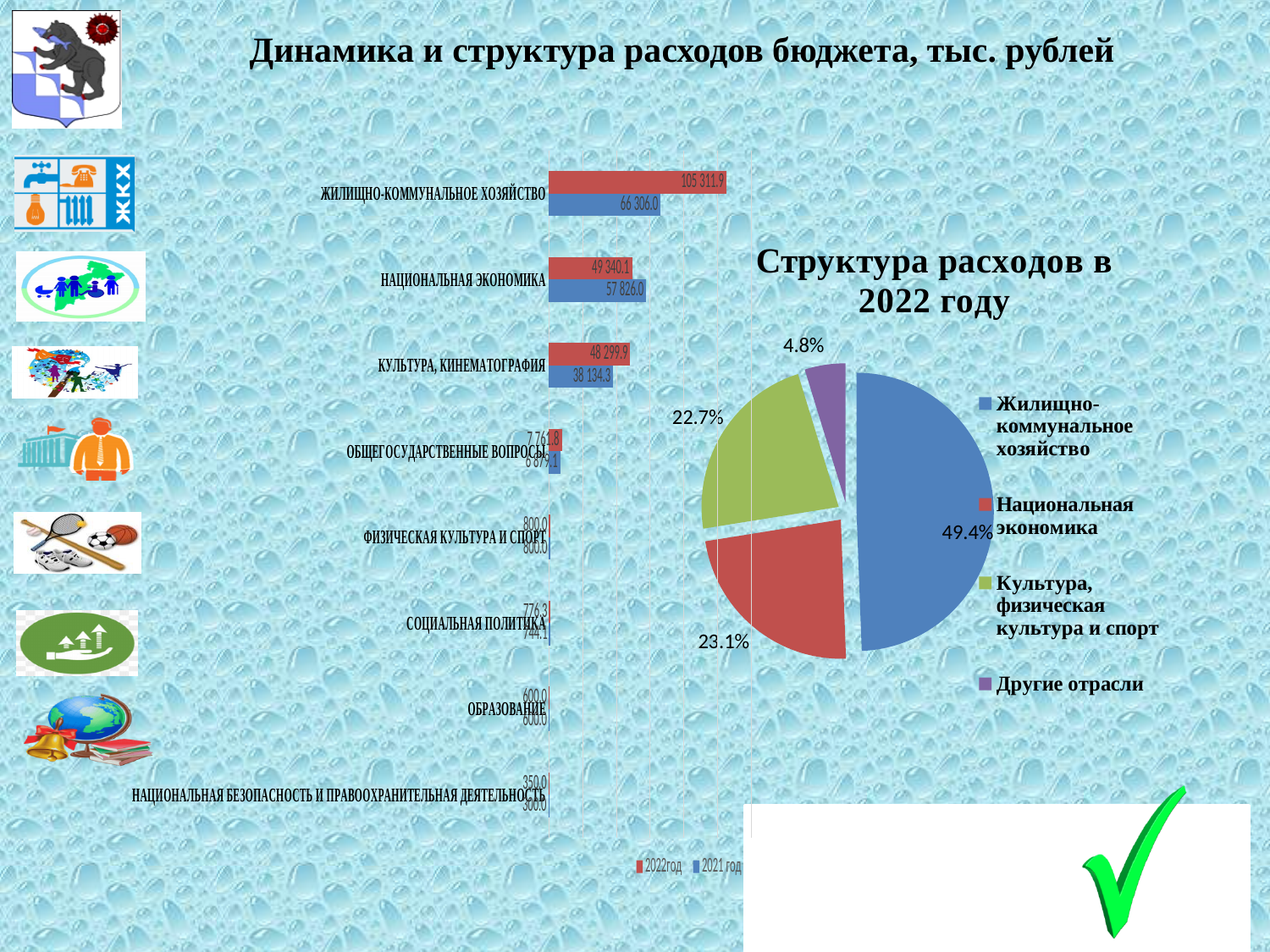
In the pie chart 'Структура расходов в 2022 году', how many slices are there? 4 In the bar chart on the left, what is the 2022 value for Жилищно-коммунальное хозяйство? 105 311.9 In the bar chart on the left, what is the 2022 value for Культура, кинематография? 48 299.9 In the bar chart on the left, what is the 2021 value for Национальная экономика? 57 826.0 In the bar chart on the left, which category has the highest 2022 value? Жилищно-коммунальное хозяйство In the pie chart 'Структура расходов в 2022 году', which slice is the smallest? Другие отрасли In the bar chart on the left, how many categories are shown? 8 In the pie chart 'Структура расходов в 2022 году', what share does Жилищно-коммунальное хозяйство have? 49.4% In the bar chart on the left, how many series does the legend list? 2 In the bar chart on the left, what is the difference between the 2022 and 2021 values for Жилищно-коммунальное хозяйство? 39 005.9 In the bar chart on the left, for Национальная экономика, which year has the larger value, 2022 or 2021? 2021 What type of chart is the chart on the left of the slide? Bar chart